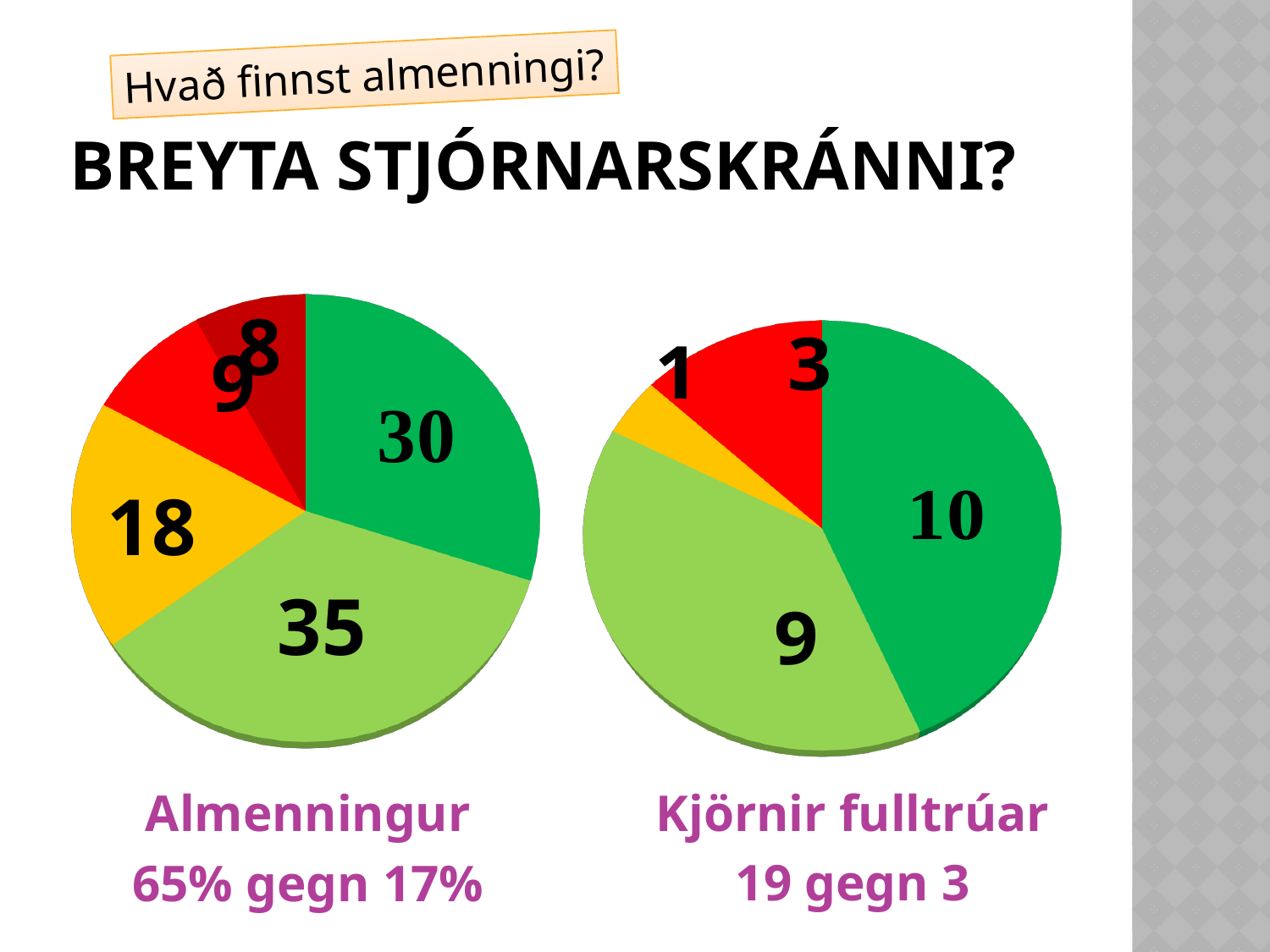
In the left chart ("Almenningur"), what share of the pie does the yellow slice (18) represent? 18% In the right chart ("Kjörnir fulltrúar"), what is the difference between the dark green slice and the light green slice? 1 In the left chart ("Almenningur"), what is the total of all the slice values? 100 In the left chart ("Almenningur"), which slice has the largest value? the light green slice (35) In the right chart ("Kjörnir fulltrúar"), how many slices does the pie have? 4 In the left chart ("Almenningur"), what value is shown on the light green slice? 35 In the left chart ("Almenningur"), what is the difference between the light green slice and the dark green slice? 5 In the left chart ("Almenningur"), which is larger, the dark green slice or the yellow slice? the dark green slice In the right chart ("Kjörnir fulltrúar"), which slice has the smallest value? the yellow slice (1) In the left chart ("Almenningur"), how many slices does the pie have? 5 What kind of chart is the left chart labelled "Almenningur"? pie chart In the right chart ("Kjörnir fulltrúar"), what value is shown on the red slice? 3